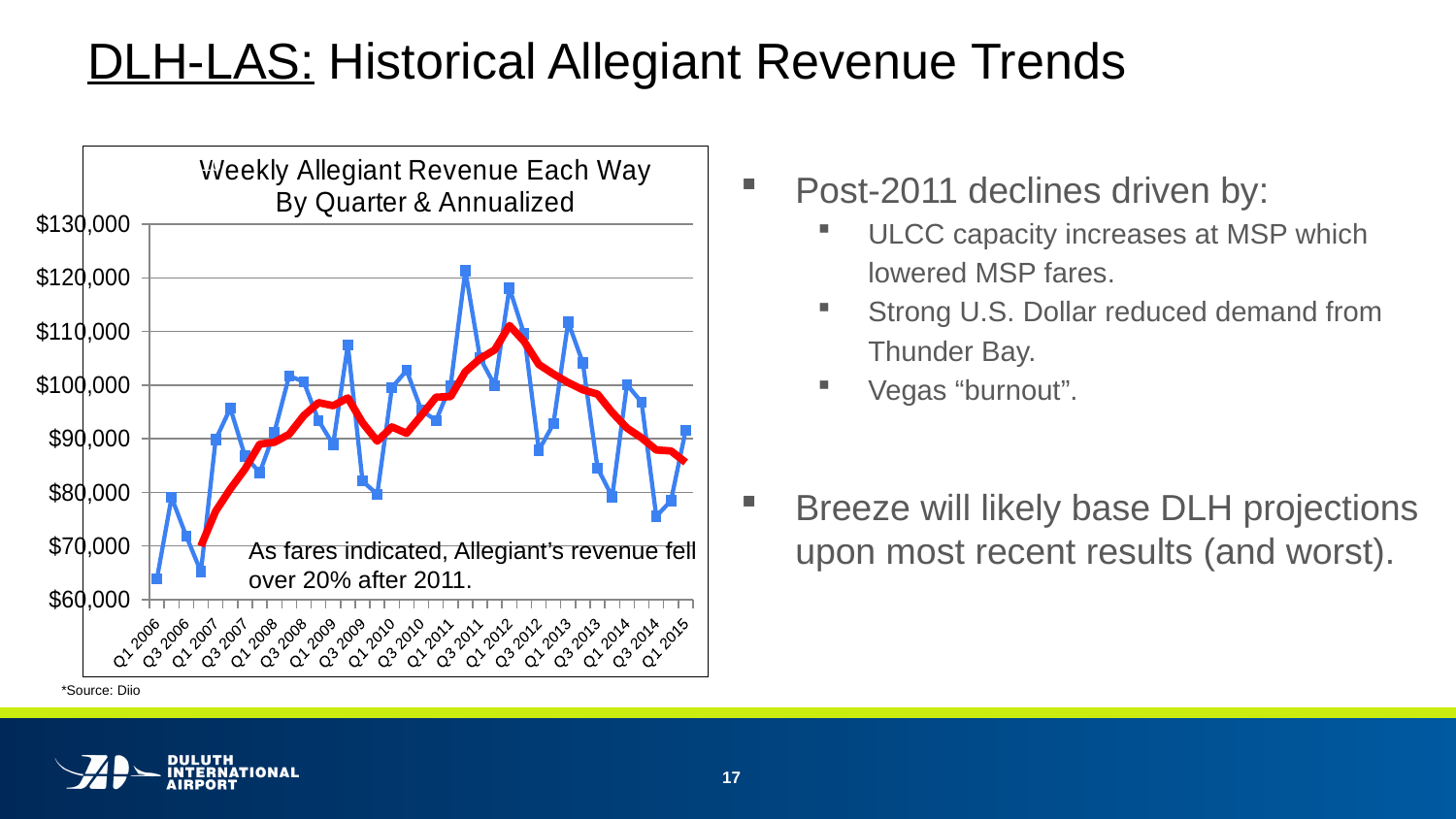
What is the first quarter label on the x axis? Q1 2006 What is the lowest value shown on the y axis? $60,000 What is the title of the chart? Weekly Allegiant Revenue Each Way By Quarter & Annualized What is the highest value shown on the y axis? $130,000 Does the red annualized line rise or fall from 2012 to Q1 2015? fall What kind of chart is shown on the slide? line chart Is the value for Q1 2006 greater or less than $70,000? less How many quarter labels are shown on the x axis? 19 Does the red annualized line rise or fall from Q1 2007 to Q3 2008? rise Which is larger, the value for Q1 2006 or the value for Q1 2015? Q1 2015 Is the highest point on the blue line greater or less than $120,000? greater Is the value for Q1 2015 greater or less than $80,000? greater